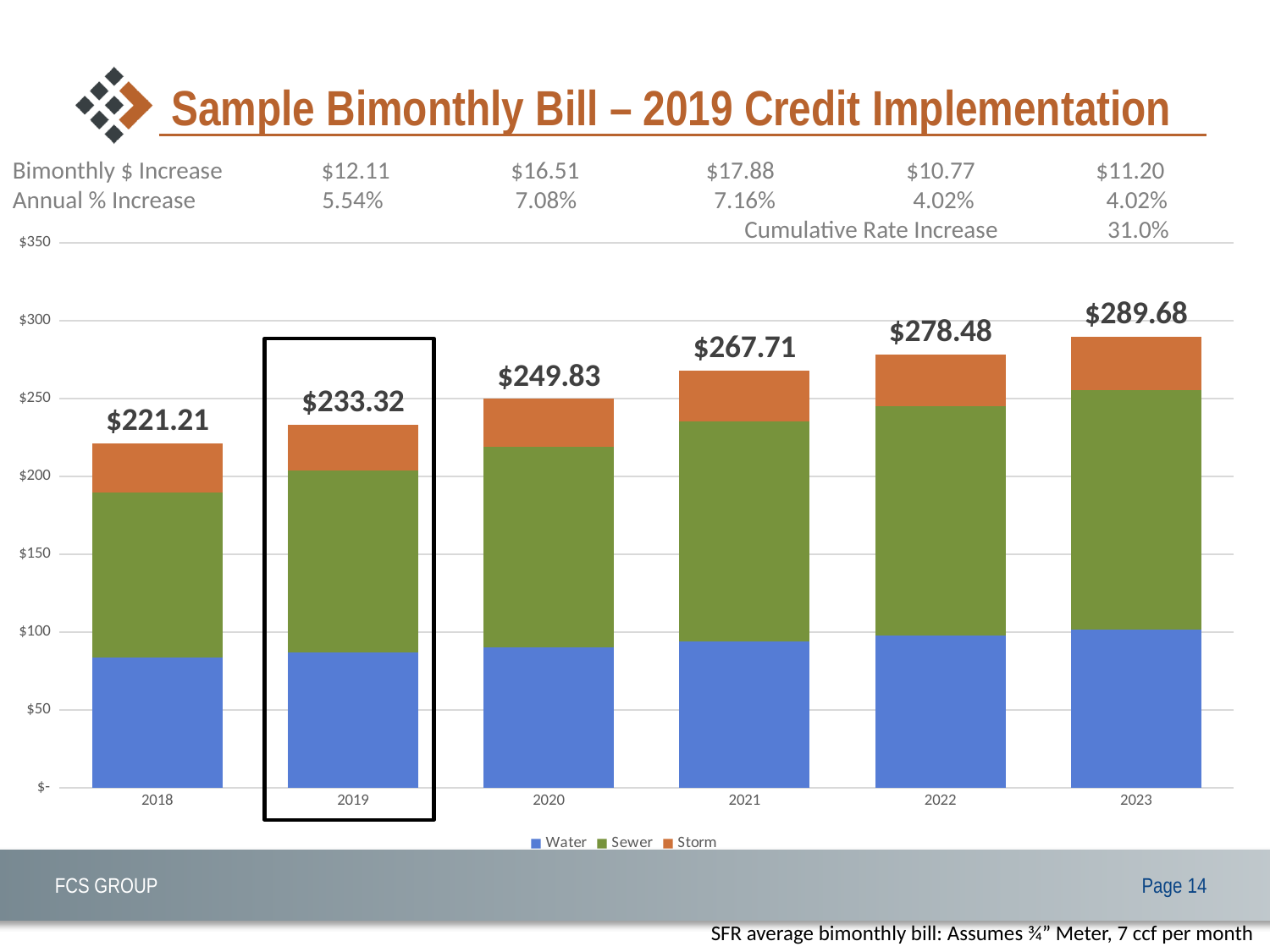
How many years are shown on the x axis of the chart? 6 What is the difference between the total bill for 2023 and the total bill for 2018? $68.47 What is the total bimonthly bill shown for 2021? $267.71 What kind of chart is shown on the slide? stacked bar chart What is the difference between the total bill for 2020 and the total bill for 2019? $16.51 Which year has the highest total bimonthly bill? 2023 Do the total bimonthly bills rise or fall from 2018 to 2023? rise Is the total bill for 2022 larger or smaller than the total bill for 2021? larger How many series does the chart legend list? 3 Which year has the lowest total bimonthly bill? 2018 What is the total bimonthly bill shown for 2019? $233.32 Is the Water portion of the 2018 bar greater or less than $100? less